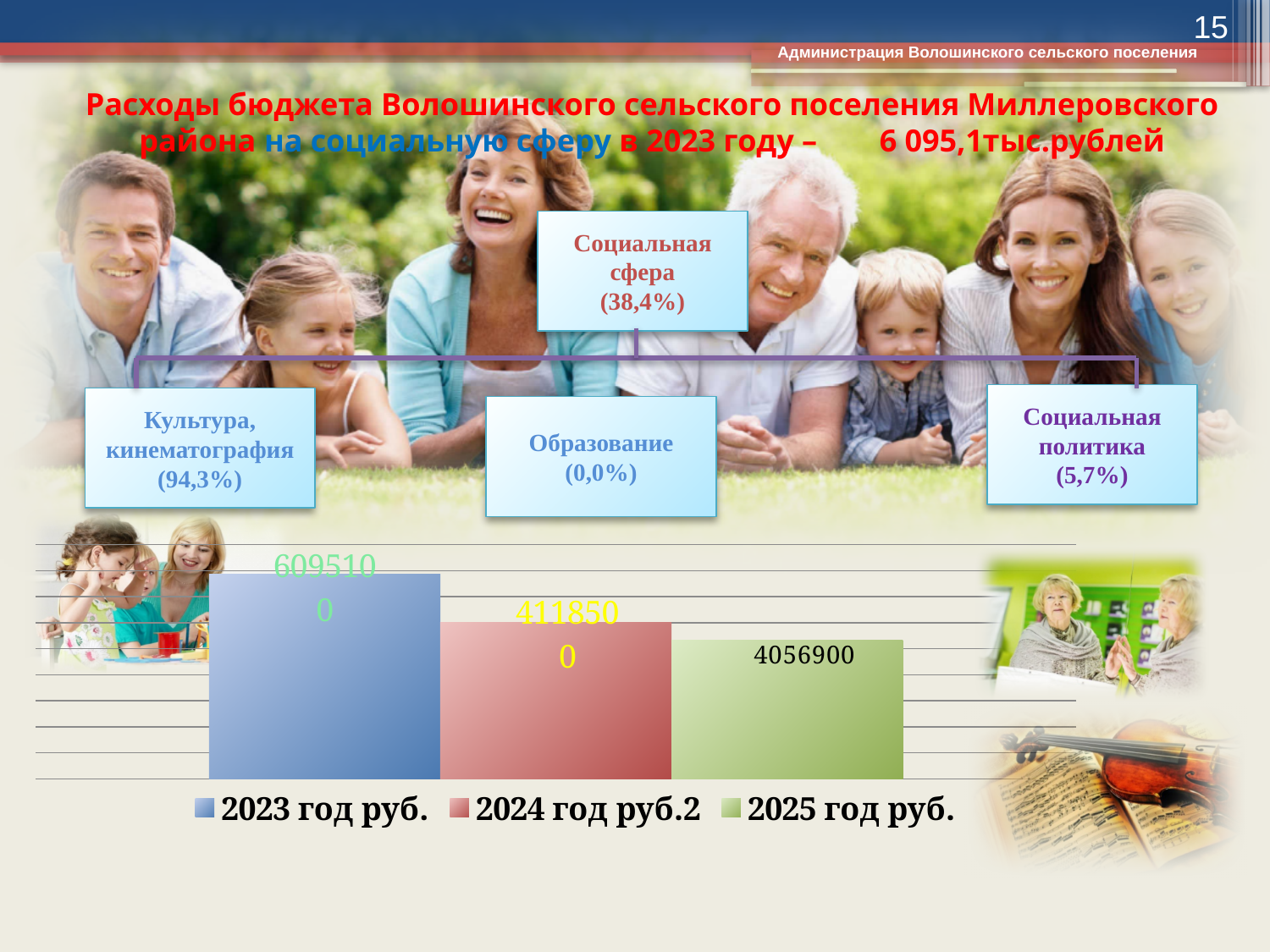
Do the values rise or fall from the 2023 bar to the 2025 bar? fall What is the difference between the values for "2023 год руб." and "2024 год руб.2"? 1976600 What is the value shown for the series "2025 год руб."? 4056900 What type of chart is shown at the bottom of the slide? bar chart What is the value shown for the series "2023 год руб."? 6095100 What is the difference between the values for "2024 год руб.2" and "2025 год руб."? 61600 Which series has the lowest value in the chart? 2025 год руб. How many series does the chart legend list? 3 Which series has the highest value in the chart? 2023 год руб. What is the value shown for the series "2024 год руб.2"? 4118500 How many bars are plotted in the chart? 3 Which is larger, the value for "2023 год руб." or the value for "2025 год руб."? 2023 год руб.